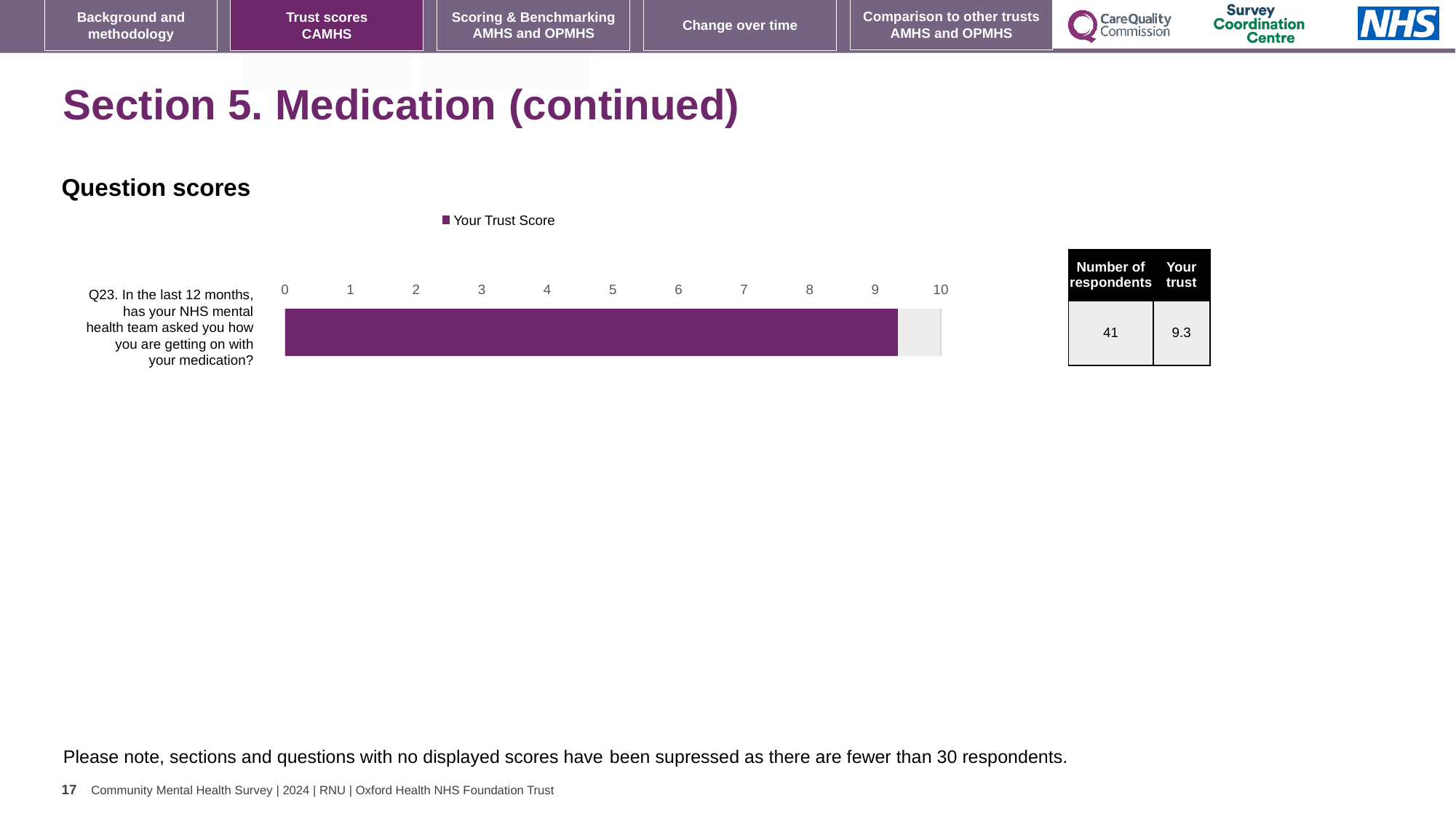
What is the trust score for Q23 shown in the table beside the chart? 9.3 What type of chart is shown under "Question scores"? bar chart Is the bar for Q23 greater or less than 10 on the axis? less What series name appears in the chart legend? Your Trust Score What is the maximum value shown on the chart's horizontal axis? 10 How many bars are plotted in the chart? 1 Which question number is plotted in the chart? Q23 How many series does the chart legend list? 1 How many respondents are listed for Q23 in the table next to the chart? 41 Is the bar for Q23 greater or less than 9 on the axis? greater